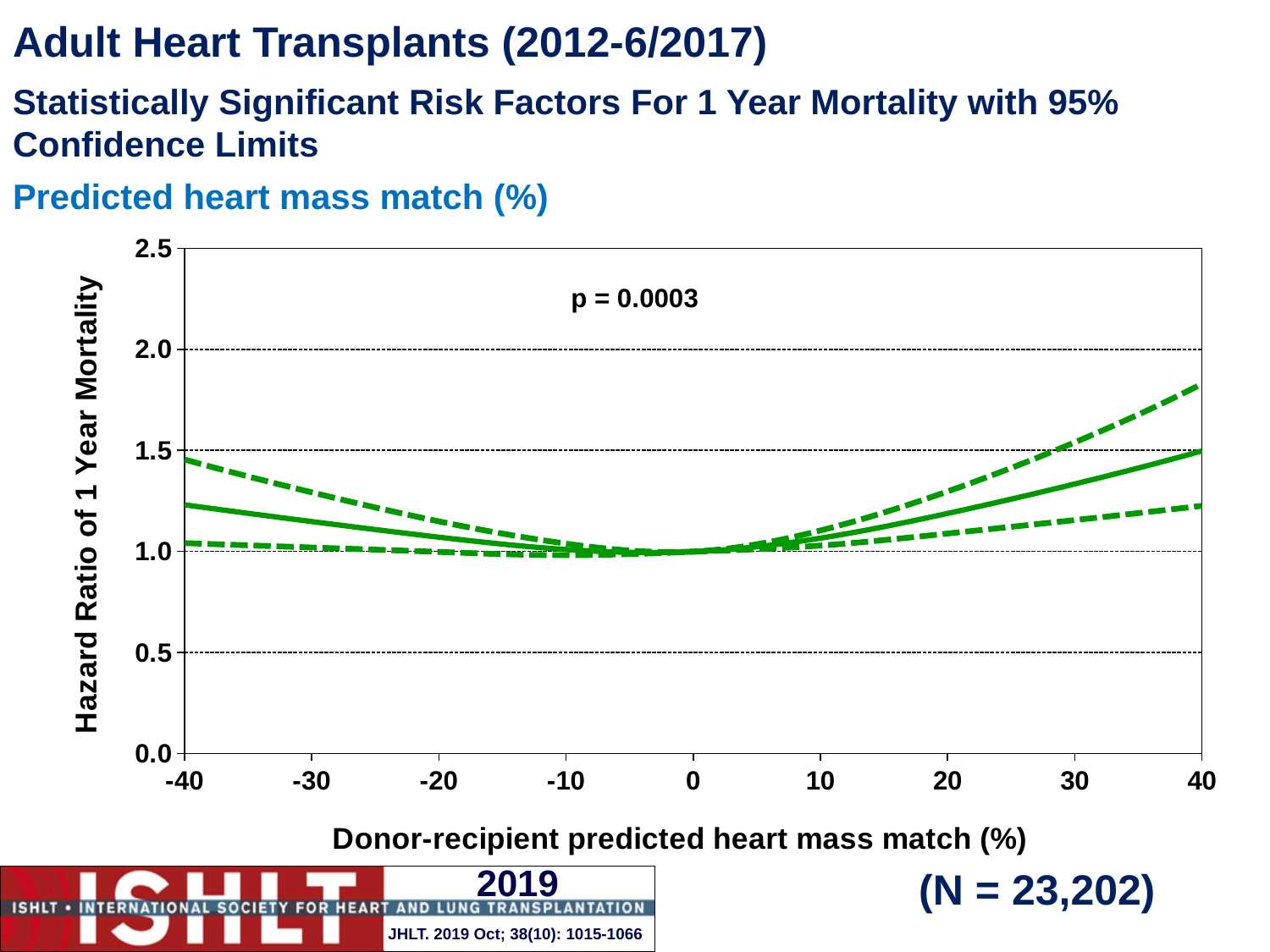
Does the solid hazard ratio line rise or fall as the predicted heart mass match increases from 0% to 40%? rise What is the sample size (N) shown on the slide? N = 23,202 Is the value of the lower dashed confidence limit at a predicted heart mass match of 40% greater or less than 1.5? less Is the solid hazard ratio line higher at a predicted heart mass match of 40% or at -40%? 40% How many lines are plotted on the chart? 3 Is the value of the upper dashed confidence limit at a predicted heart mass match of 40% greater or less than 1.5? greater What is the p-value printed on the chart? p = 0.0003 Is the value of the solid hazard ratio line at a predicted heart mass match of -40% greater or less than 1.5? less What kind of chart is shown on the slide? line chart Does the solid hazard ratio line rise or fall as the predicted heart mass match increases from -40% to 0%? fall